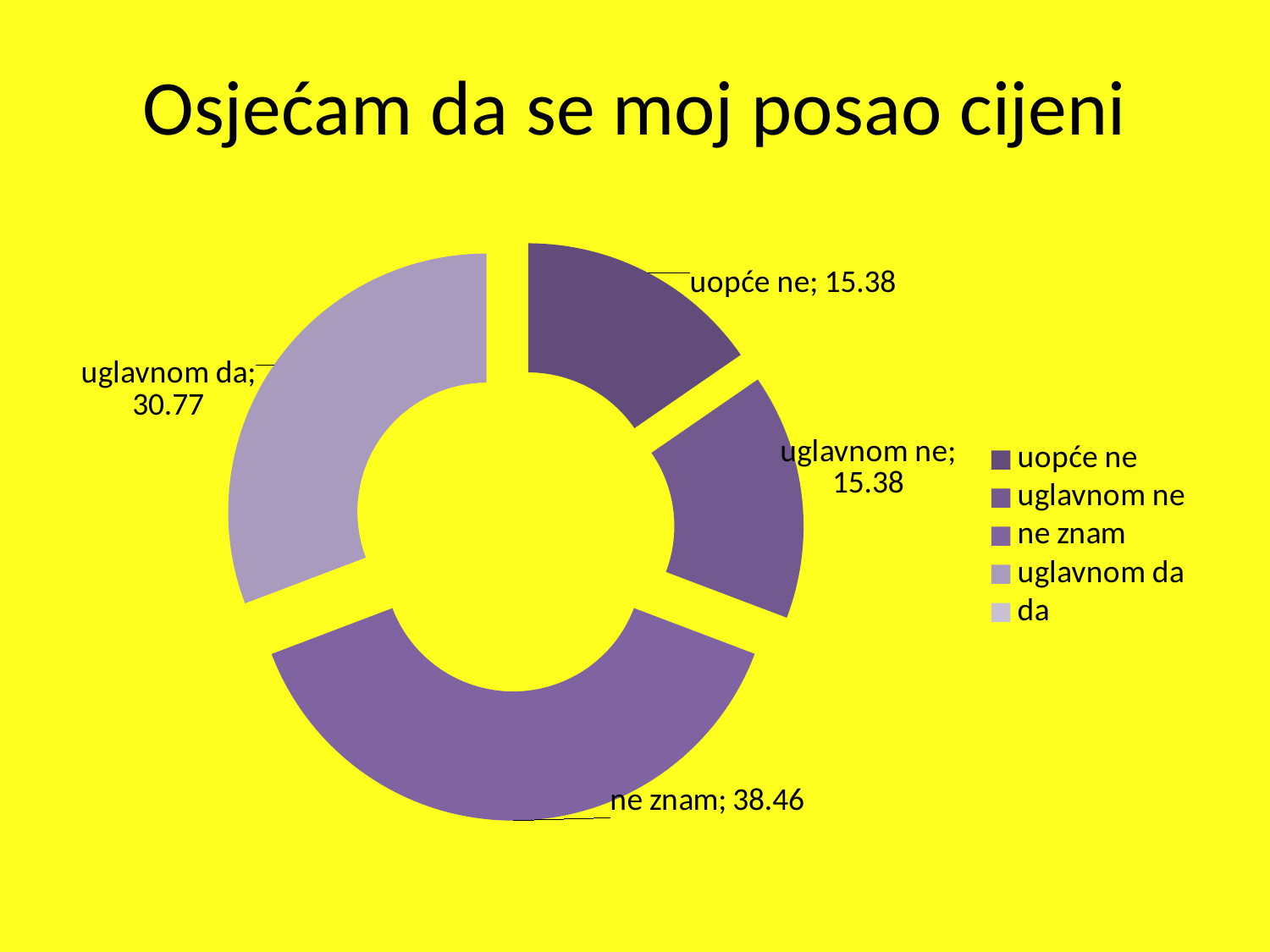
Which is larger, the value for "ne znam" or the value for "uglavnom da"? ne znam Which category has the largest slice? ne znam What is the difference between the values for "ne znam" and "uglavnom da"? 7.69 What is the value shown for "uglavnom ne"? 15.38 What is the value shown for "uglavnom da"? 30.77 What is the difference between the values for "uglavnom da" and "uopće ne"? 15.39 What is the title of the chart? Osjećam da se moj posao cijeni What kind of chart is shown on the slide? doughnut (pie) chart What is the value shown for "ne znam"? 38.46 What is the value shown for "uopće ne"? 15.38 Which is larger, the value for "uglavnom da" or the value for "uglavnom ne"? uglavnom da How many entries does the legend list? 5